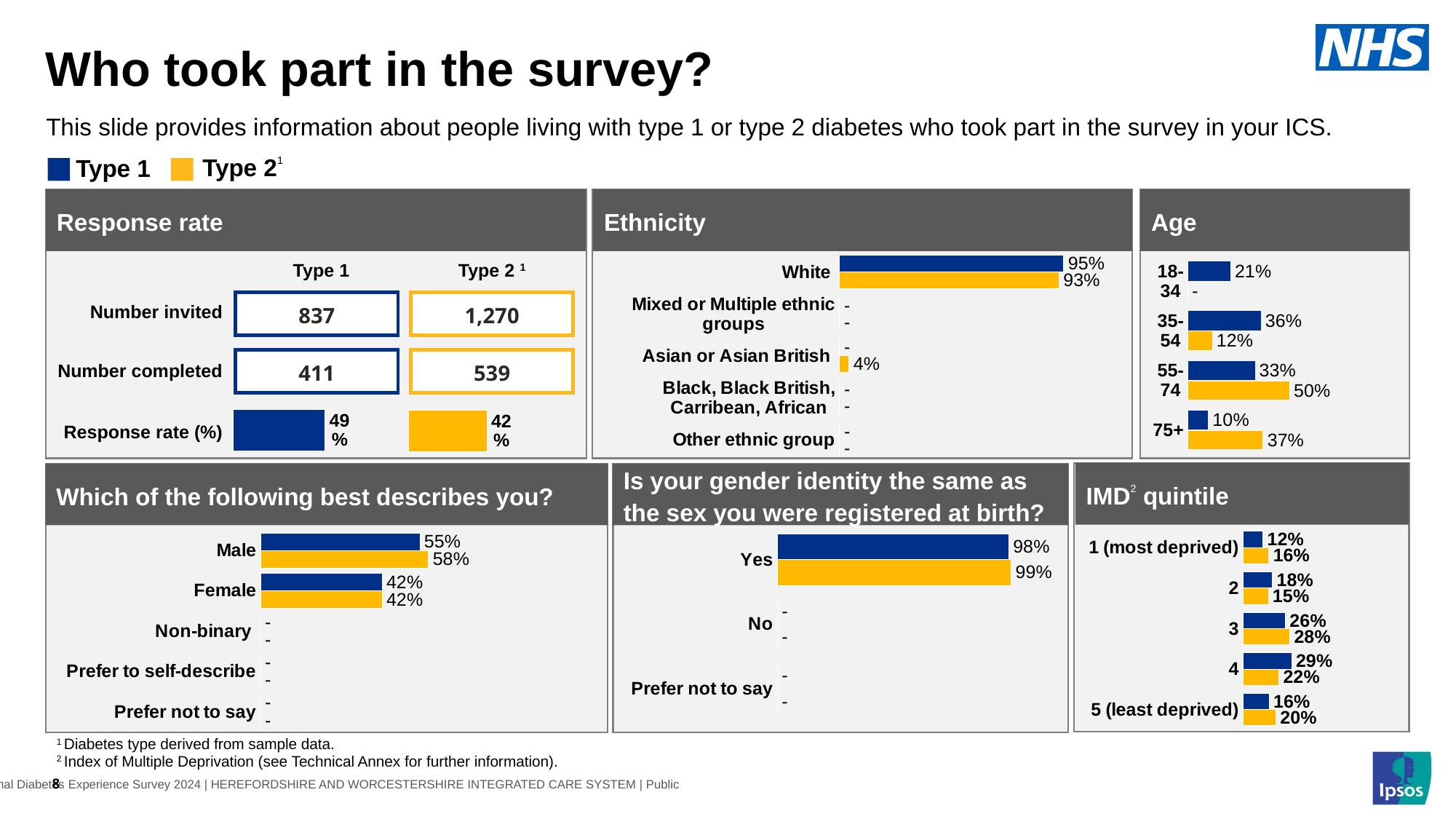
In the IMD quintile chart, what is the difference between the Type 1 and Type 2 values for quintile 4? 7% In the IMD quintile chart, what is the Type 2 value for quintile 3? 28% In the IMD quintile chart, which quintile has the highest Type 1 value? 4 How many series does the legend at the top of the slide list? 2 In the Age chart, what is the Type 2 value for the 55-74 age group? 50% In the 'Which of the following best describes you?' chart, which is larger for Type 1: Male or Female? Male In the Age chart, which age group has the highest Type 1 value? 35-54 In the Response rate chart, what is the response rate for Type 2? 42% In the Ethnicity chart, what is the Type 1 value for White? 95% In the Age chart, what is the difference between the Type 2 and Type 1 values for 75+? 27% In the gender identity chart, what is the Type 2 value for Yes? 99% In the 'Which of the following best describes you?' chart, what is the Type 2 value for Male? 58%